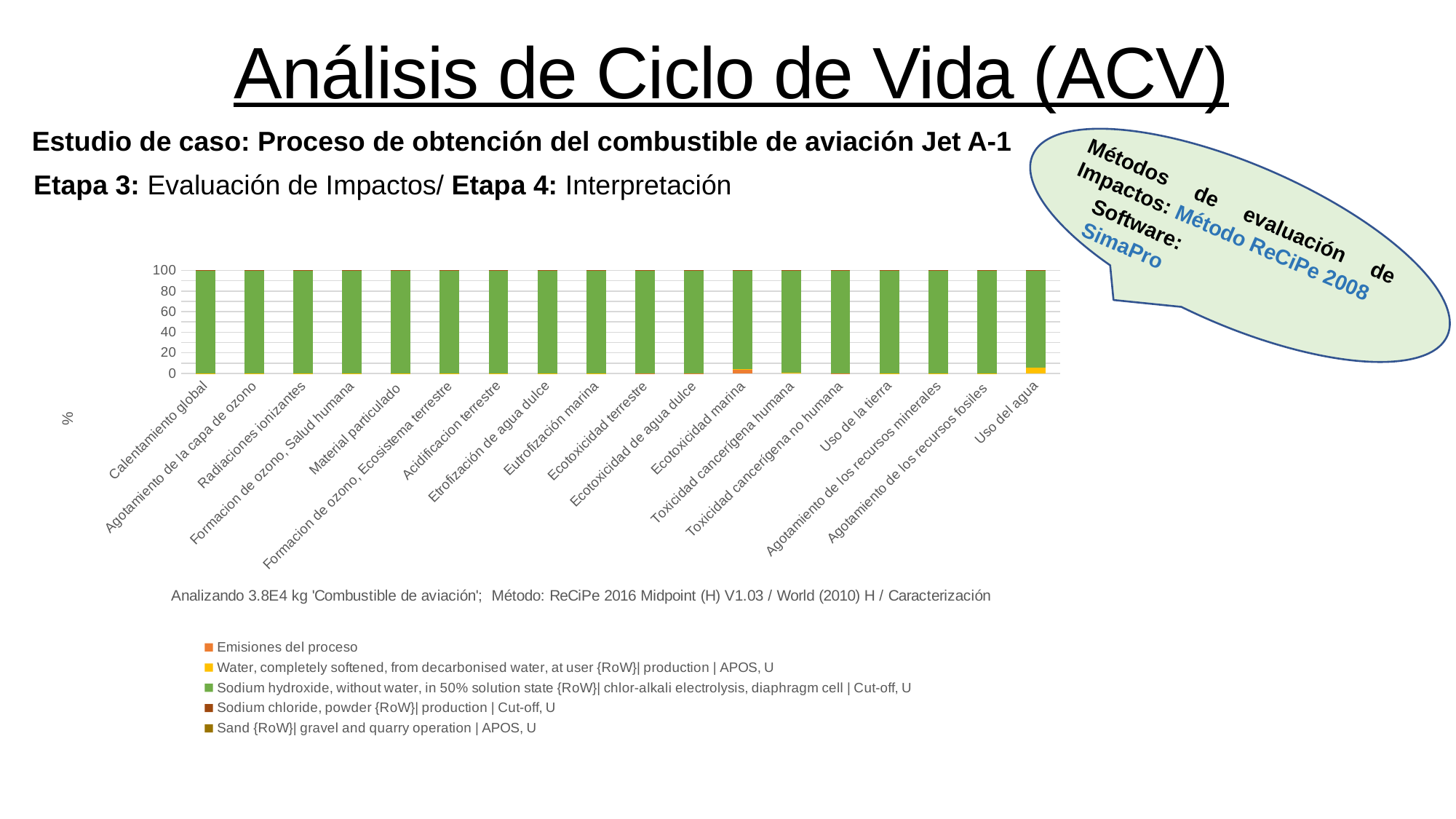
Which category shows a visible yellow (Water, completely softened) segment at the bottom of its bar? Uso del agua What is the total height of the stacked bar for Uso del agua? 100 How many impact categories are plotted along the x axis of the chart? 18 Is the yellow segment for Uso del agua greater or less than 20? less Which category shows a visible orange (Emisiones del proceso) segment at the bottom of its bar? Ecotoxicidad marina Is the orange segment for Ecotoxicidad marina greater or less than 20? less What is the total height of the stacked bar for Calentamiento global? 100 What kind of chart is shown on the slide? Stacked bar chart What label is shown on the y axis of the chart? % Is the green segment for Uso del agua greater or less than 80? greater How many series does the chart legend list? 5 Which legend series is represented by the green colour that fills most of every bar? Sodium hydroxide, without water, in 50% solution state {RoW}| chlor-alkali electrolysis, diaphragm cell | Cut-off, U